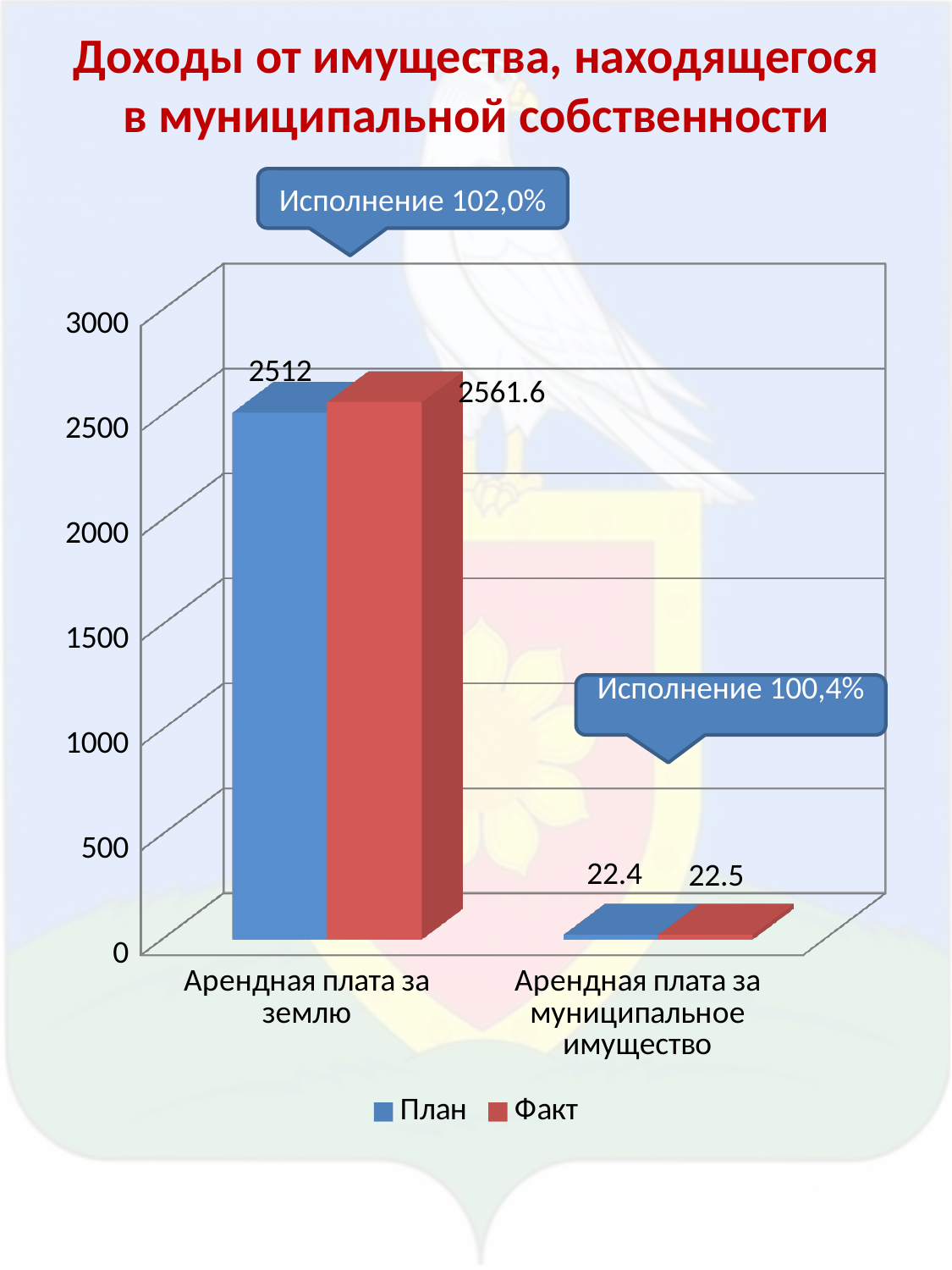
How many series does the legend list? 2 Is the Факт value for Арендная плата за землю greater or less than 2500? greater What is the План value for Арендная плата за муниципальное имущество? 22.4 What is the Факт value for Арендная плата за муниципальное имущество? 22.5 Which category has the lowest План value? Арендная плата за муниципальное имущество Which is larger for Арендная плата за землю: the План value or the Факт value? Факт What is the План value for Арендная плата за землю? 2512 How many categories are shown on the x axis? 2 Which category has the highest Факт value? Арендная плата за землю What kind of chart is shown on the slide? bar chart What is the Факт value for Арендная плата за землю? 2561.6 What is the difference between the Факт and План values for Арендная плата за землю? 49.6